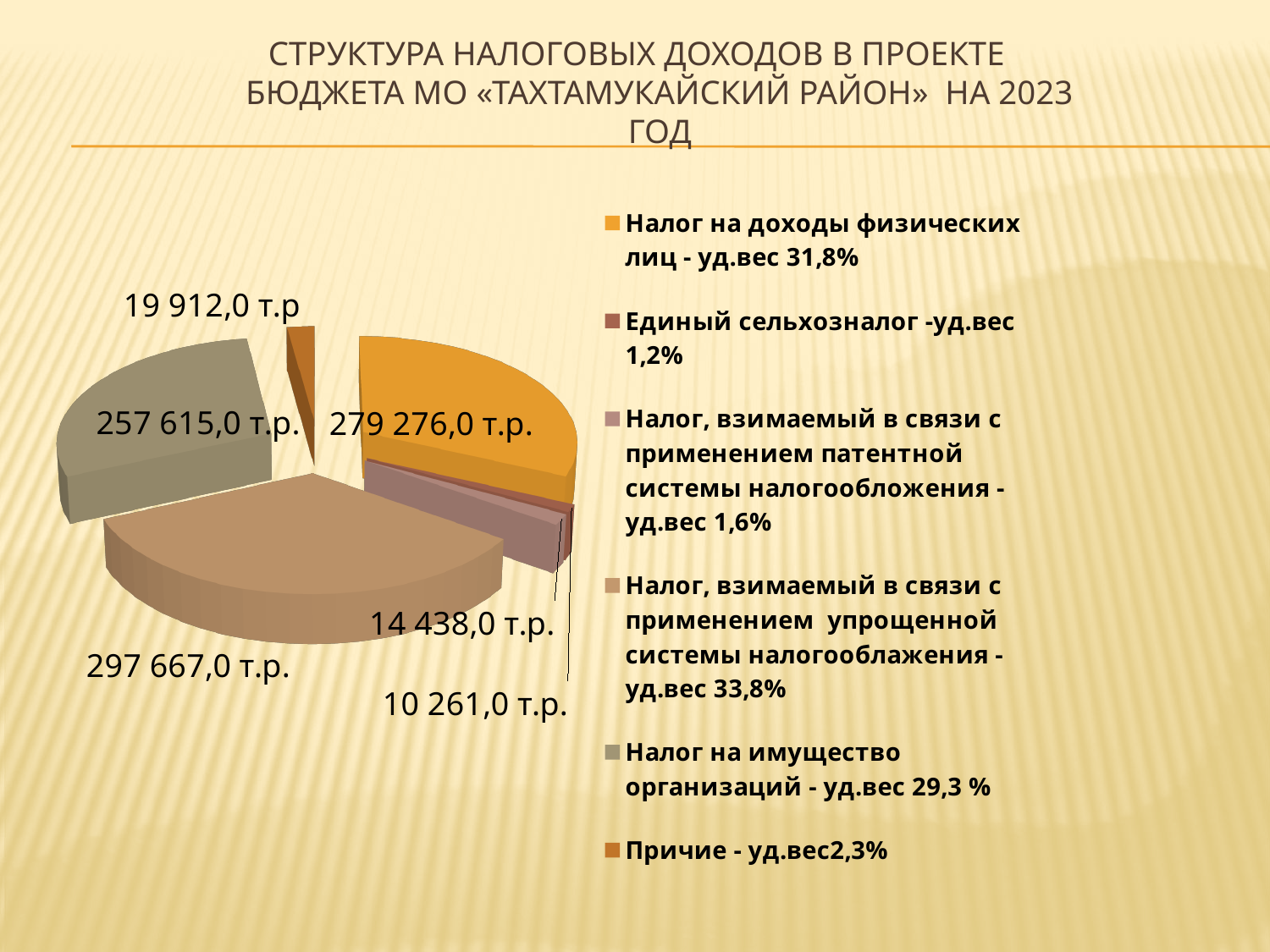
Which category has the largest slice of the pie? Налог, взимаемый в связи с применением упрощенной системы налогообложения What is the value shown for Единый сельхозналог? 10 261,0 т.р. What is the value shown for Налог, взимаемый в связи с применением упрощенной системы налогообложения? 297 667,0 т.р. How many entries does the legend list? 6 What share of the pie does Налог на имущество организаций represent, according to the legend? 29,3 % Which is larger: the value for Налог на доходы физических лиц or the value for Налог на имущество организаций? Налог на доходы физических лиц What is the value shown for Налог на доходы физических лиц? 279 276,0 т.р. How many slices does the pie chart have? 6 What is the value shown for Налог на имущество организаций? 257 615,0 т.р. What is the difference between the value for Налог, взимаемый в связи с применением патентной системы налогообложения and the value for Единый сельхозналог? 4 177,0 т.р. Which category has the smallest slice of the pie? Единый сельхозналог What type of chart is shown on the slide? pie chart